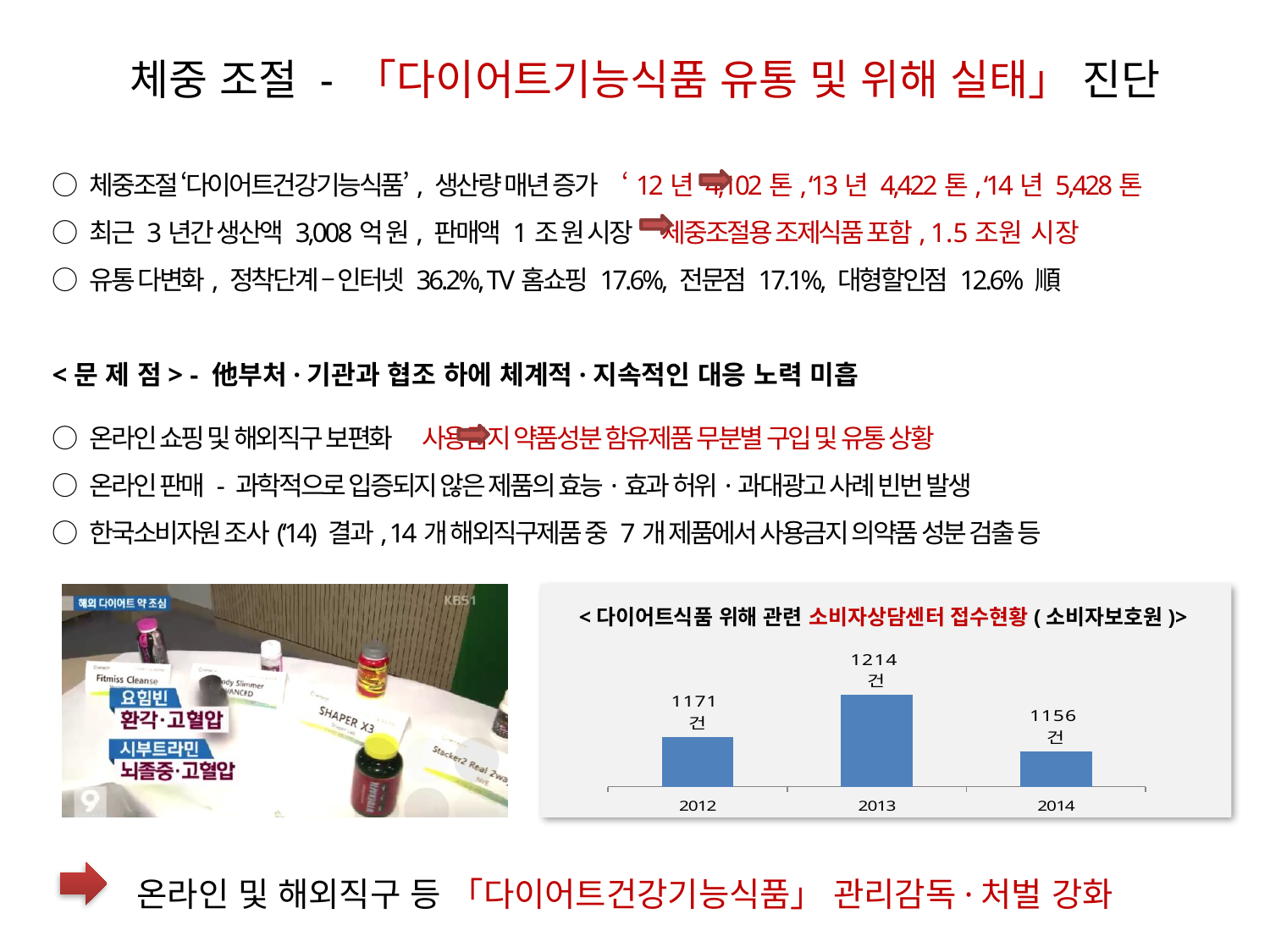
Which is larger in the bar chart, the value for 2012 or the value for 2014? 2012 Which year has the highest value in the bar chart? 2013 Does the value in the bar chart rise or fall from 2013 to 2014? fall What is the value for 2012 in the bar chart? 1171 건 What is the title of the bar chart? < 다이어트식품 위해 관련 소비자상담센터 접수현황 ( 소비자보호원 )> What is the difference between the 2013 and 2014 values in the bar chart? 58 건 How many years are shown on the x axis of the bar chart? 3 What is the value for 2013 in the bar chart? 1214 건 What is the value for 2014 in the bar chart? 1156 건 What is the difference between the 2013 and 2012 values in the bar chart? 43 건 Which year has the lowest value in the bar chart? 2014 What kind of chart is shown on the slide? bar chart